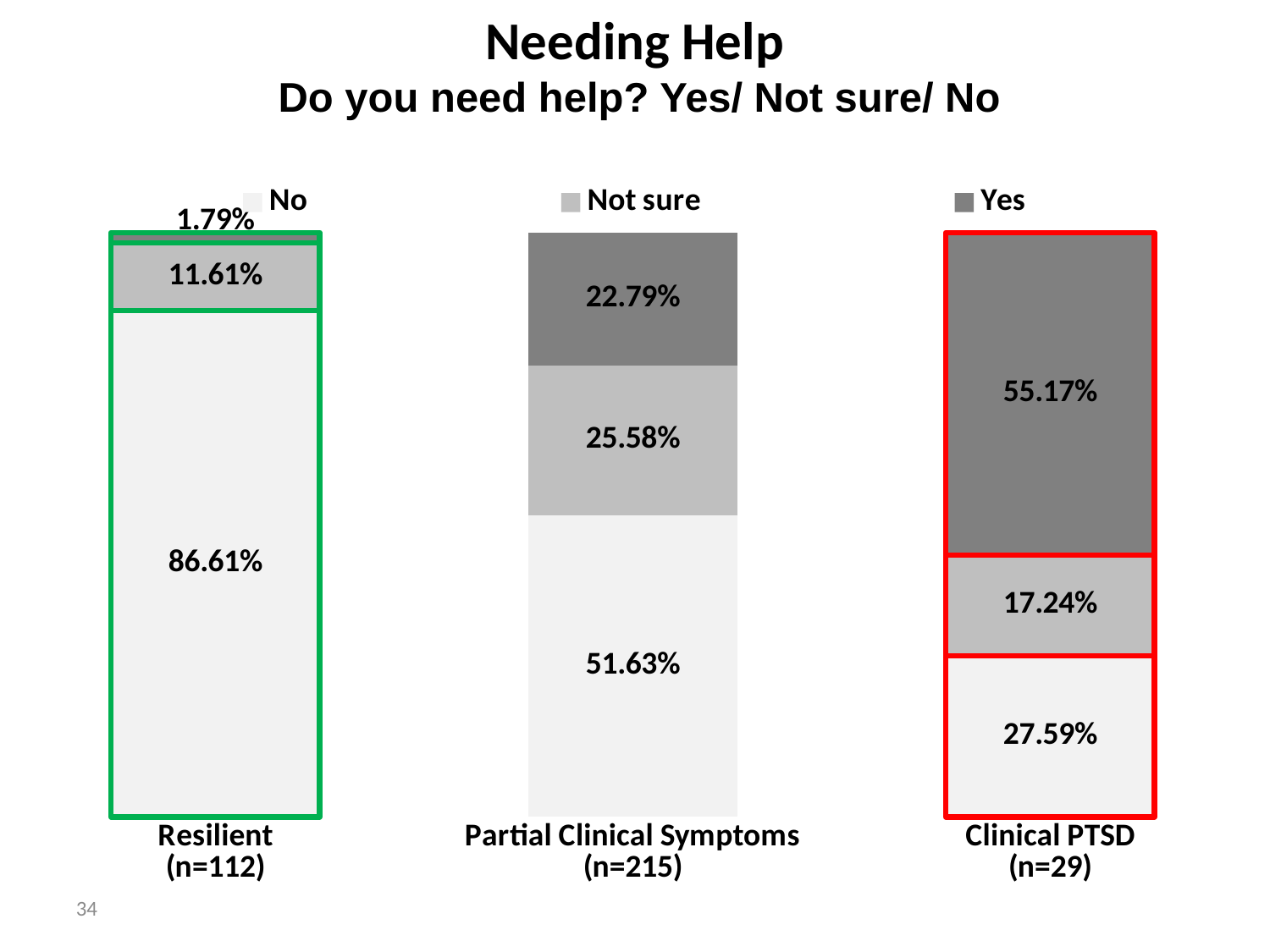
How many categories (groups) are shown on the x axis? 3 How many series does the legend list? 3 Which group has the lowest "No" percentage? Clinical PTSD What is the difference between the "No" percentage for the Resilient group and the "No" percentage for the Partial Clinical Symptoms group? 34.98% What percentage of the Resilient group answered "Yes"? 1.79% Which is larger: the "Not sure" percentage for the Partial Clinical Symptoms group or the "Not sure" percentage for the Clinical PTSD group? Partial Clinical Symptoms What kind of chart is shown on the slide? Stacked bar chart What percentage of the Resilient group answered "No"? 86.61% What percentage of the Partial Clinical Symptoms group answered "Not sure"? 25.58% What is the sample size (n) shown for the Partial Clinical Symptoms group? n=215 Which group has the highest "Yes" percentage? Clinical PTSD What percentage of the Clinical PTSD group answered "Yes"? 55.17%